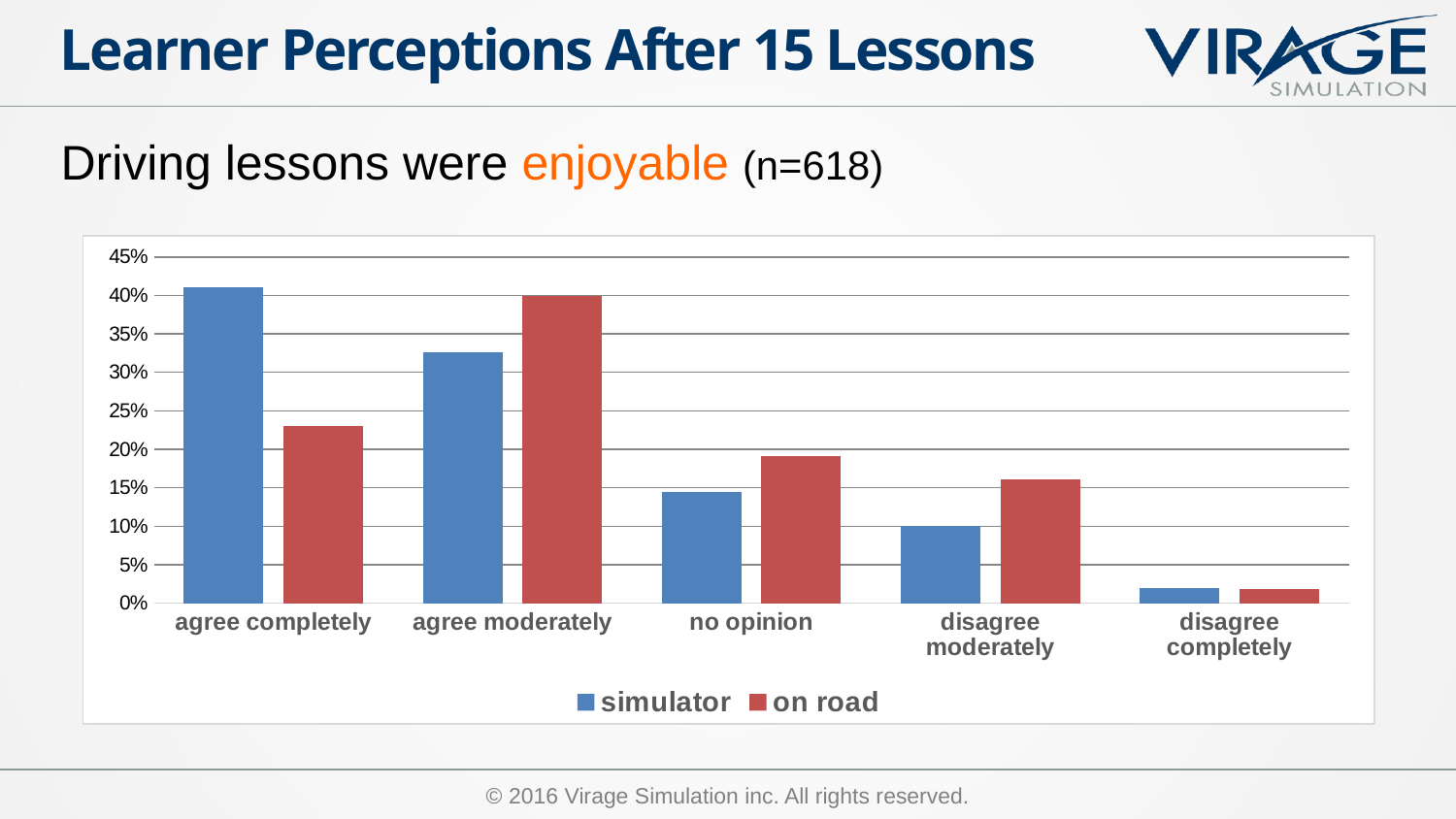
Is the simulator value for 'agree completely' greater or less than 35%? greater What kind of chart is shown on the slide? bar chart Which category has the highest value for the on road series? agree moderately How many series does the legend list? 2 Which category has the highest value for the simulator series? agree completely For 'agree completely', which series has the larger value, simulator or on road? simulator Which category has the lowest value for the simulator series? disagree completely What colour represents the on road series in the legend? red Do the simulator values rise or fall moving from 'agree completely' to 'disagree completely' along the x axis? fall For 'no opinion', which series has the larger value, simulator or on road? on road Is the on road value for 'agree completely' greater or less than 25%? less How many response categories are shown on the x axis? 5